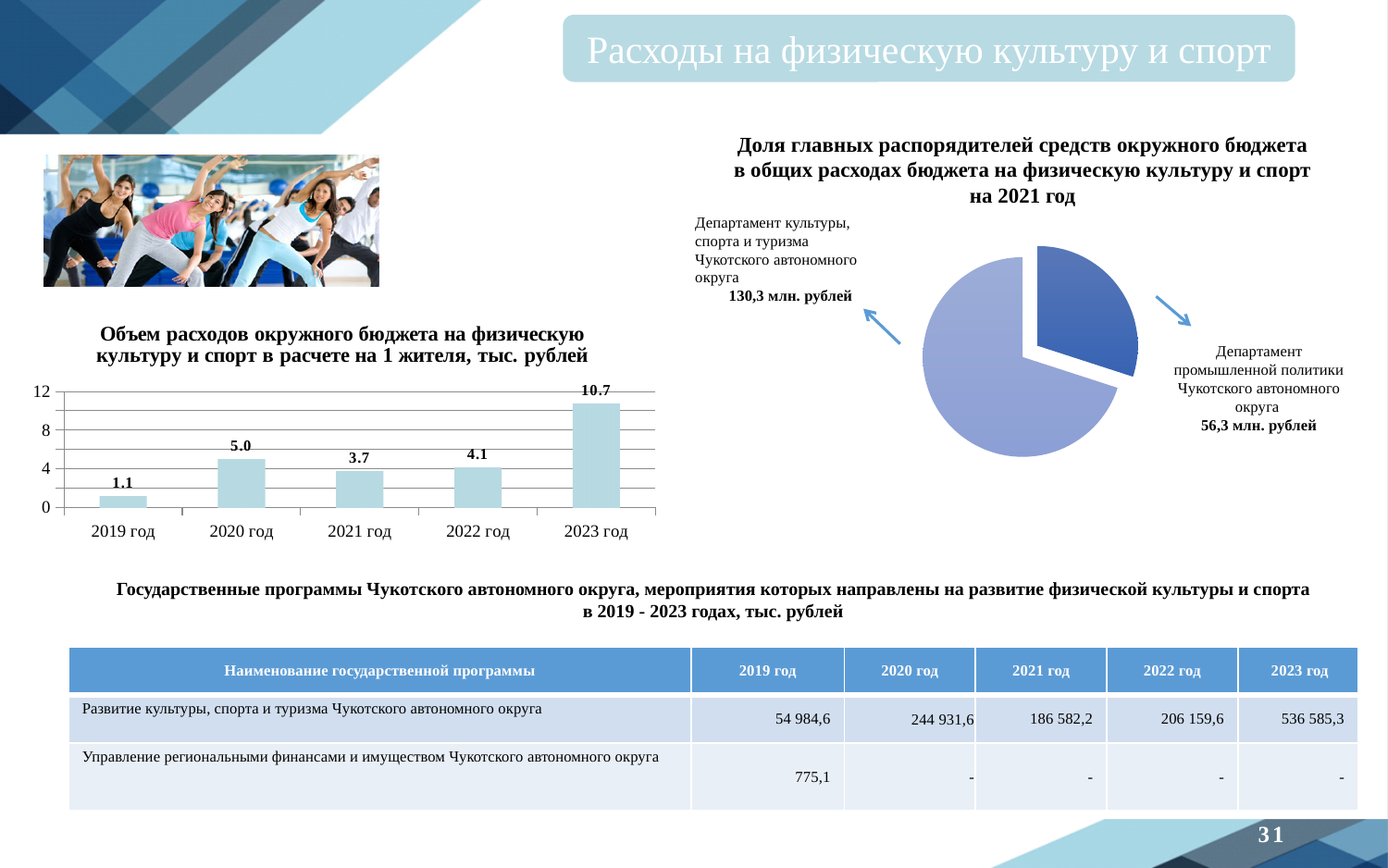
What type of chart is 'Объем расходов окружного бюджета на физическую культуру и спорт в расчете на 1 жителя'? Bar chart On the bar chart 'Объем расходов окружного бюджета на физическую культуру и спорт в расчете на 1 жителя', what is the value for 2019 год? 1.1 On the bar chart 'Объем расходов окружного бюджета на физическую культуру и спорт в расчете на 1 жителя', how many years are shown? 5 On the pie chart 'Доля главных распорядителей средств окружного бюджета ... на 2021 год', what is the value for Департамент промышленной политики Чукотского автономного округа? 56,3 млн. рублей On the bar chart 'Объем расходов окружного бюджета на физическую культуру и спорт в расчете на 1 жителя', what is the value for 2021 год? 3.7 On the bar chart 'Объем расходов окружного бюджета на физическую культуру и спорт в расчете на 1 жителя', which year has the highest value? 2023 год On the bar chart 'Объем расходов окружного бюджета на физическую культуру и спорт в расчете на 1 жителя', what is the value for 2023 год? 10.7 On the pie chart 'Доля главных распорядителей средств окружного бюджета ... на 2021 год', which department has the larger share? Департамент культуры, спорта и туризма Чукотского автономного округа On the bar chart 'Объем расходов окружного бюджета на физическую культуру и спорт в расчете на 1 жителя', which is larger: the value for 2020 год or 2021 год? 2020 год On the bar chart 'Объем расходов окружного бюджета на физическую культуру и спорт в расчете на 1 жителя', what is the difference between the values for 2023 год and 2022 год? 6.6 On the pie chart 'Доля главных распорядителей средств окружного бюджета ... на 2021 год', what is the total of the two slices? 186,6 млн. рублей On the bar chart 'Объем расходов окружного бюджета на физическую культуру и спорт в расчете на 1 жителя', which year has the lowest value? 2019 год